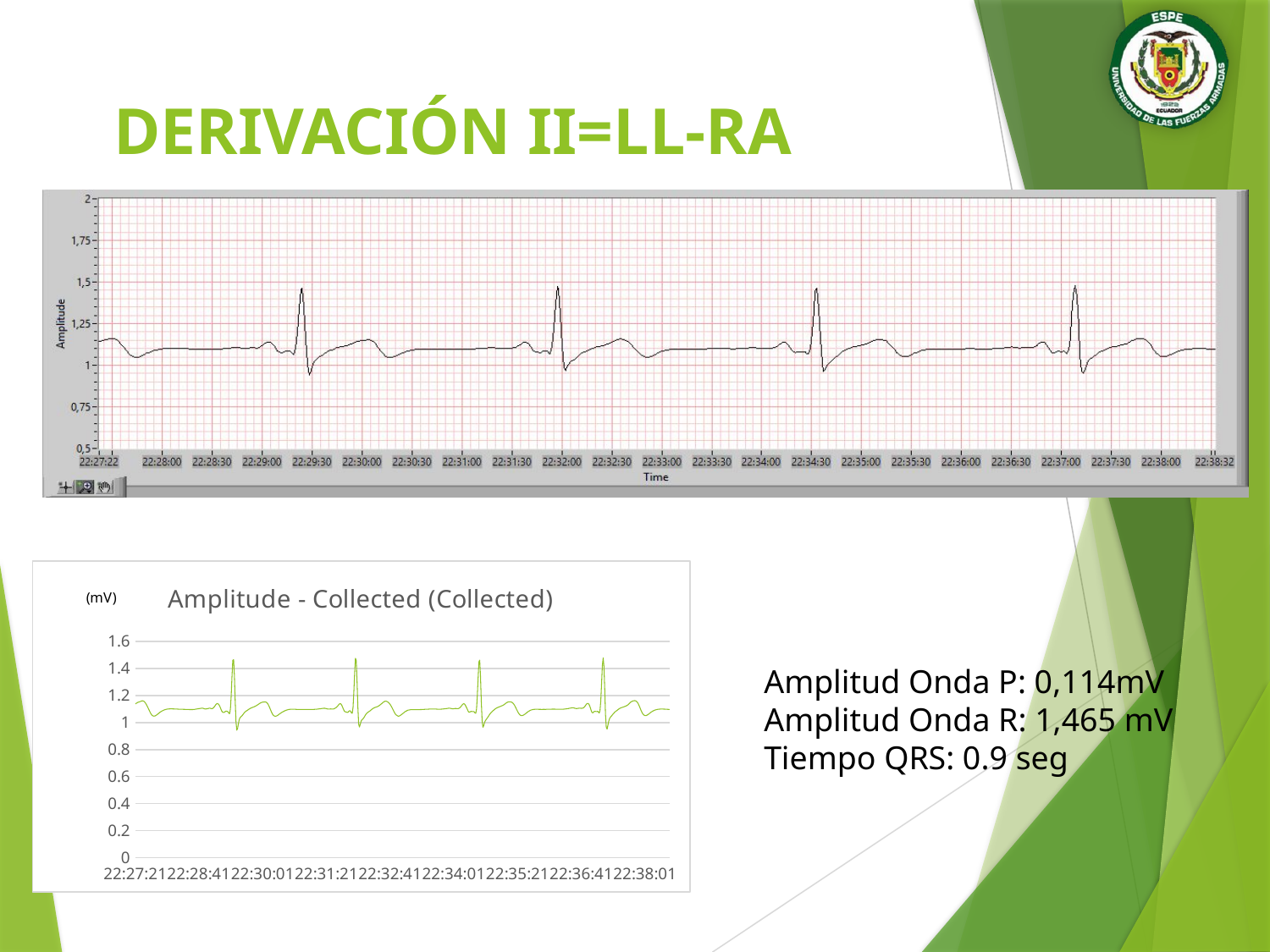
In the bottom chart "Amplitude - Collected (Collected)", how many sharp upward peaks (R waves) does the line show? 4 In the top chart, is the lowest dip of the signal after each spike greater or less than 0,75? greater What kind of chart is the top chart with the Amplitude and Time axes? Line chart What kind of chart is the bottom chart titled "Amplitude - Collected (Collected)"? Line chart In the top chart, how many sharp upward spikes does the signal show? 4 In the top chart, is the height of the tallest spikes greater or less than 1,25? greater In the bottom chart "Amplitude - Collected (Collected)", is the height of the tallest peaks greater or less than 1.2? greater What unit is shown next to the vertical axis of the bottom chart? (mV) What is the label of the horizontal axis of the top chart? Time What is the title of the bottom chart? Amplitude - Collected (Collected)